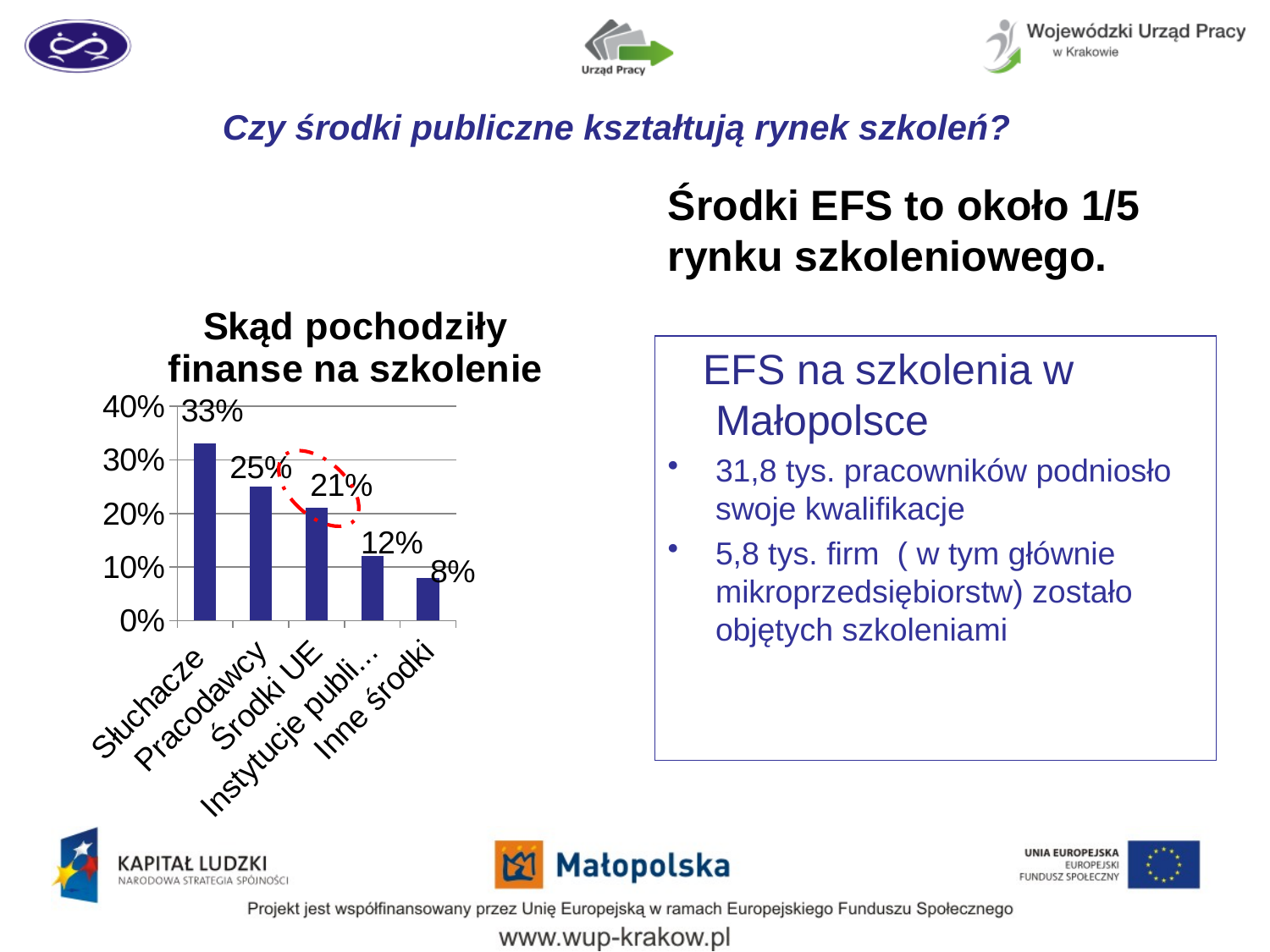
What kind of chart is shown on the slide? bar chart What is the value for Inne środki? 8% Which category has the highest value? Słuchacze What is the difference between the values for Słuchacze and Pracodawcy? 8% What is the title of the chart? Skąd pochodziły finanse na szkolenie What is the value for Środki UE? 21% What is the value for Pracodawcy? 25% What is the value for Słuchacze? 33% How many categories are shown in the chart? 5 Which is larger, the value for Pracodawcy or the value for Środki UE? Pracodawcy What is the difference between the values for Środki UE and Inne środki? 13% Which category has the lowest value? Inne środki